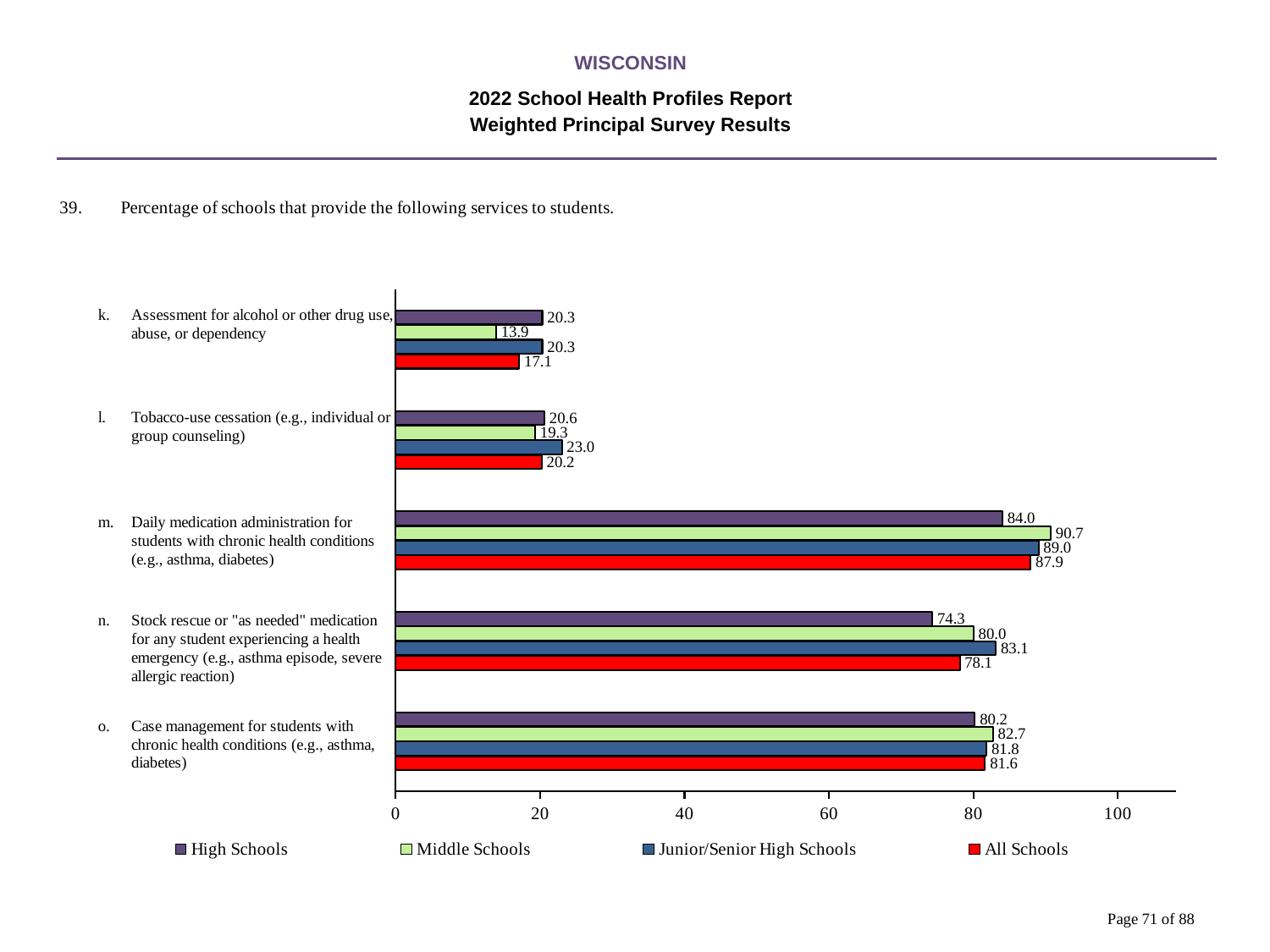
What is the All Schools value for tobacco-use cessation (e.g., individual or group counseling)? 20.2 Which school type has the highest value for daily medication administration for students with chronic health conditions? Middle Schools What is the difference between the Middle Schools and High Schools values for daily medication administration for students with chronic health conditions? 6.7 For case management for students with chronic health conditions, which is larger: the Middle Schools value or the High Schools value? Middle Schools What percentage of Middle Schools provide assessment for alcohol or other drug use, abuse, or dependency? 13.9 How many service categories are shown on the chart? 5 Which school type has the lowest value for stock rescue or "as needed" medication for any student experiencing a health emergency? High Schools What percentage of Junior/Senior High Schools provide stock rescue or "as needed" medication for any student experiencing a health emergency? 83.1 Which colour represents All Schools in the legend? red Is the All Schools value for daily medication administration for students with chronic health conditions greater or less than 80? greater What kind of chart is shown on the slide? bar chart How many series does the legend list? 4